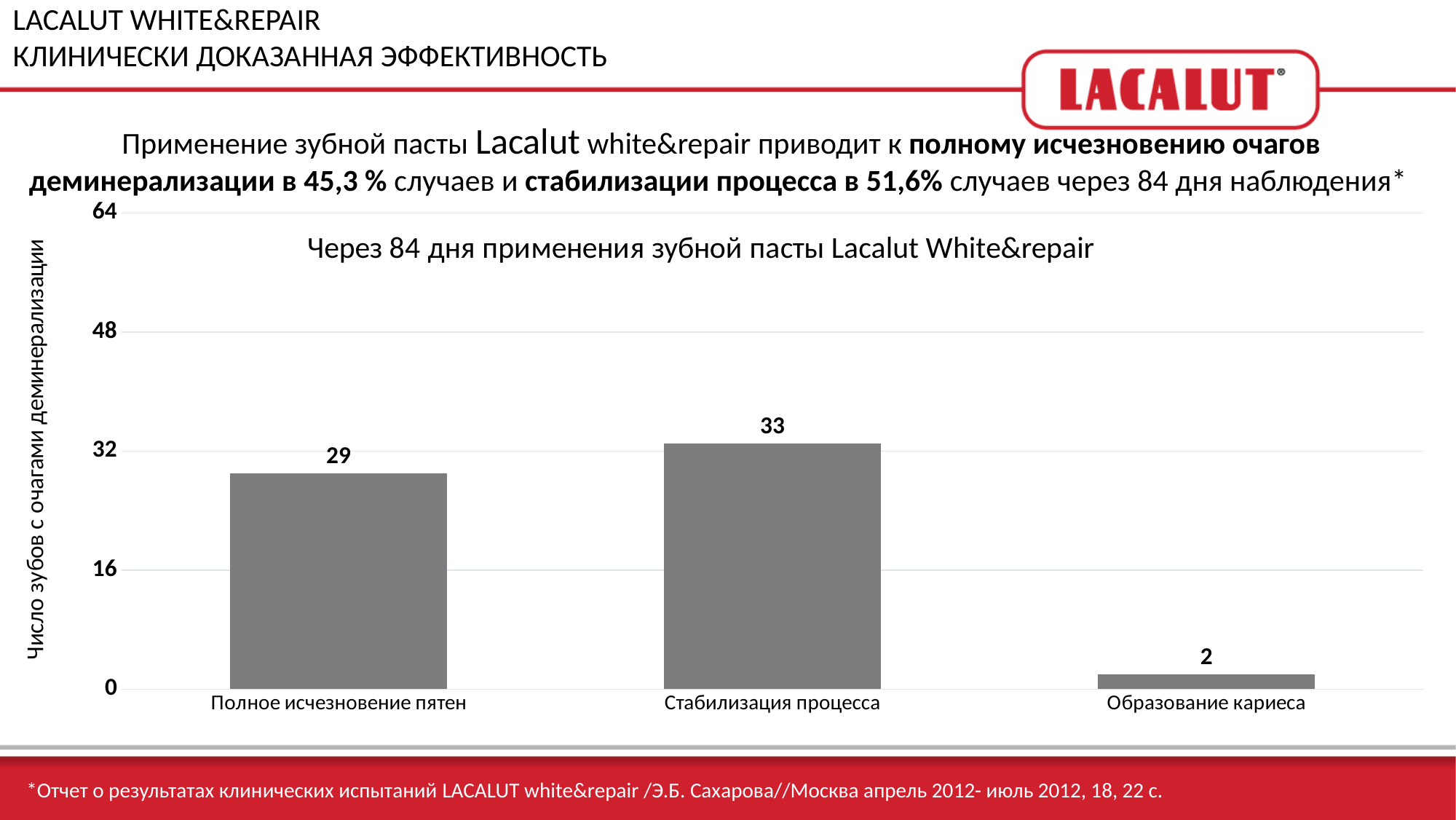
What is the value for Стабилизация процесса? 33 What is the difference between the values for Полное исчезновение пятен and Образование кариеса? 27 Which category has the highest value? Стабилизация процесса What is the value for Образование кариеса? 2 What is the value for Полное исчезновение пятен? 29 Which category has the lowest value? Образование кариеса Is the value for Полное исчезновение пятен greater or less than 32? less What kind of chart is shown on the slide? bar chart What is the difference between the values for Стабилизация процесса and Полное исчезновение пятен? 4 How many categories are shown in the chart? 3 Which is larger: the value for Полное исчезновение пятен or the value for Стабилизация процесса? Стабилизация процесса What is the title of the chart? Через 84 дня применения зубной пасты Lacalut White&repair